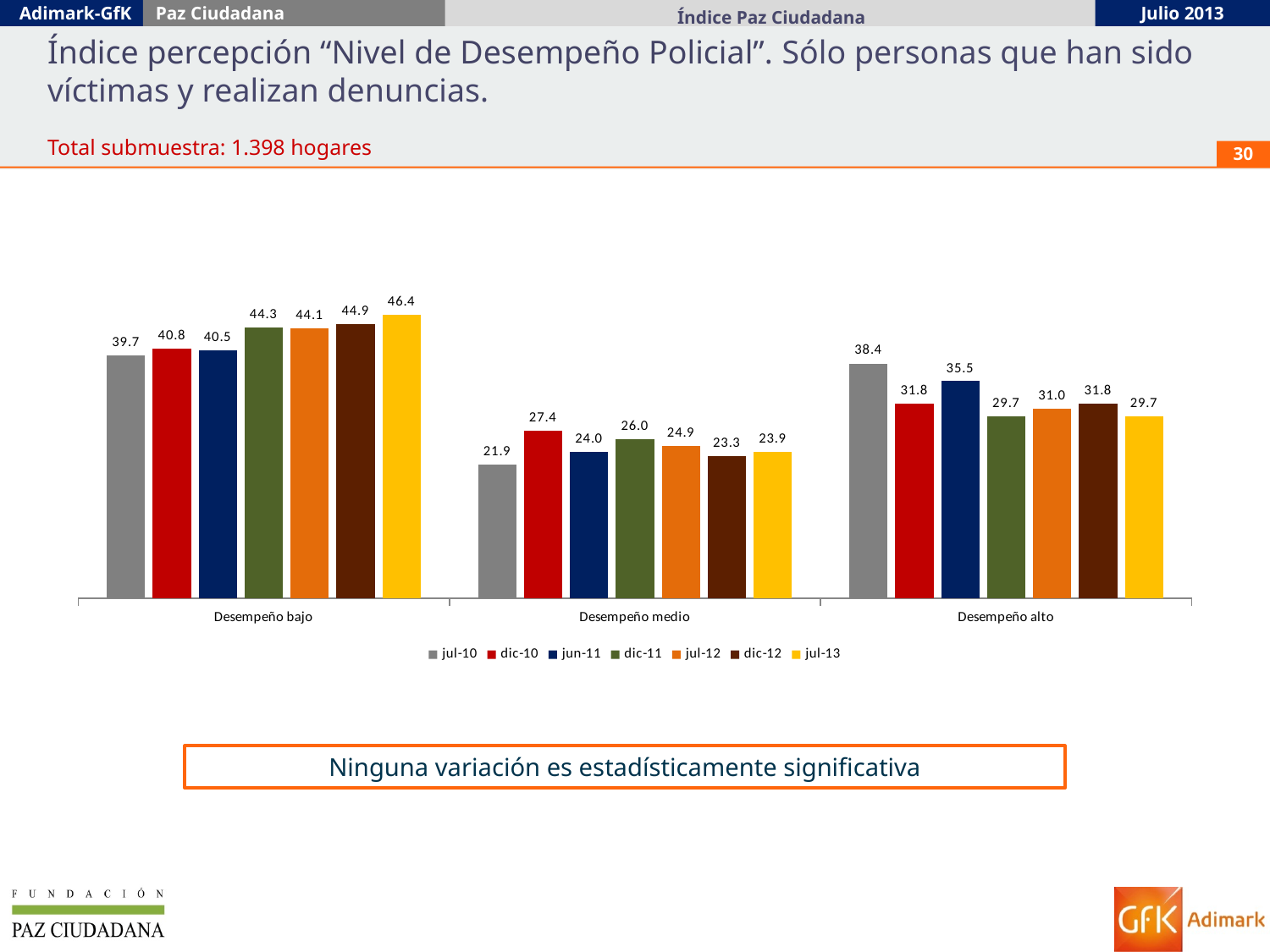
What is the difference between the jul-10 and jul-13 values in the Desempeño alto category? 8.7 Which series has the lowest value in the Desempeño medio category? jul-10 What is the value for dic-10 in the Desempeño medio category? 27.4 Which is larger in the Desempeño alto category: jun-11 or dic-11? jun-11 What is the value for jul-10 in the Desempeño alto category? 38.4 Which series has the highest value in the Desempeño bajo category? jul-13 How many categories are shown on the x axis? 3 What is the difference between the jul-13 and jul-10 values in the Desempeño bajo category? 6.7 What kind of chart is shown on the slide? Bar chart What is the value for jul-13 in the Desempeño bajo category? 46.4 How many series does the legend list? 7 What is the value for dic-12 in the Desempeño alto category? 31.8